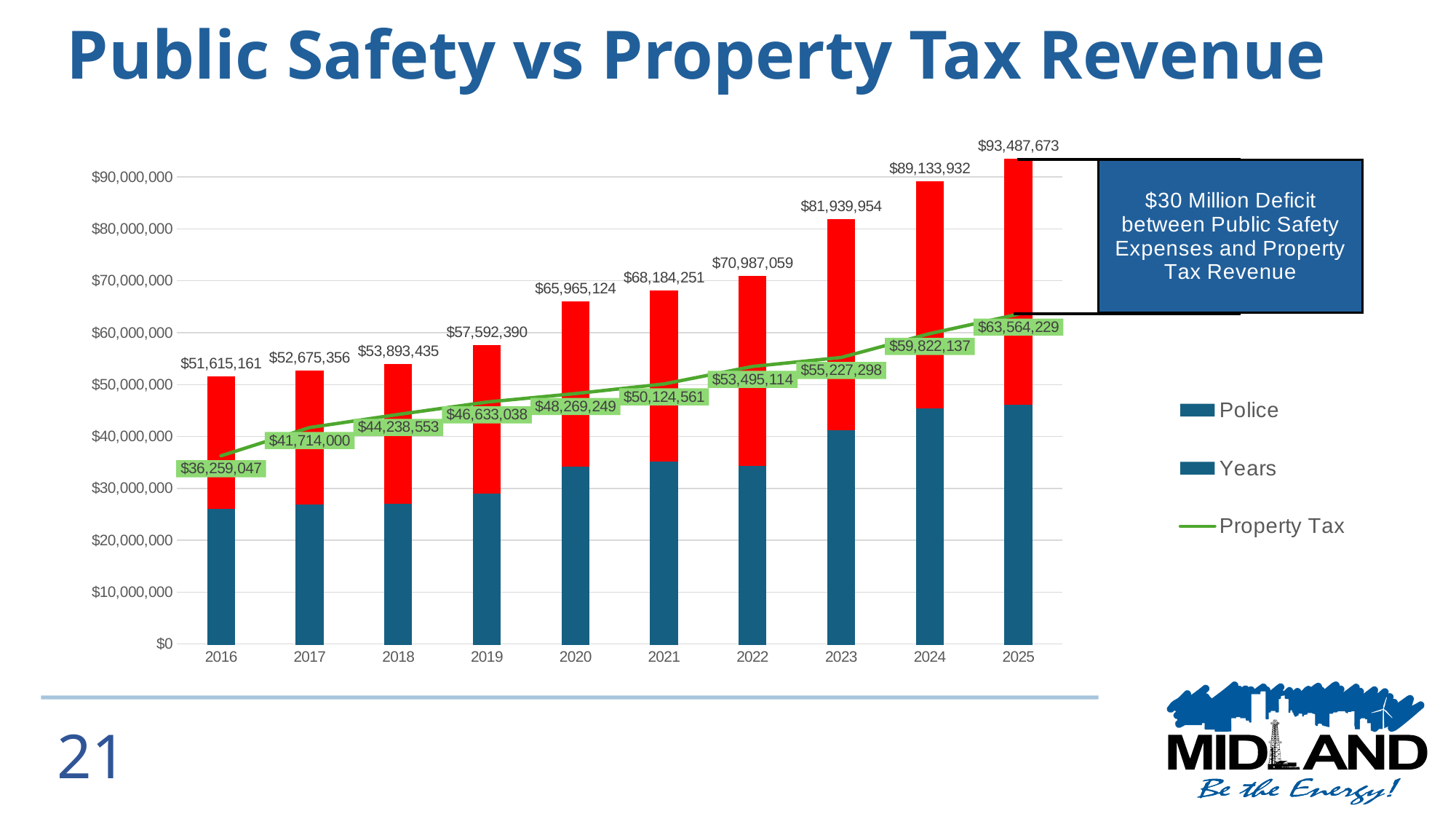
What is the Property Tax value labeled for 2021? $50,124,561 Which is larger, the bar total for 2020 or the bar total for 2019? 2020 Which year has the lowest Property Tax value? 2016 How many years are shown on the x axis? 10 Do the Property Tax values rise or fall from 2016 to 2025? rise How many series does the legend list? 3 Which year has the highest total labeled above its stacked bar? 2025 Is the Police value for 2016 greater or less than $30,000,000? less What is the difference between the 2025 bar total ($93,487,673) and the 2025 Property Tax value ($63,564,229)? $29,923,444 What is the Property Tax value labeled for 2016? $36,259,047 What is the total public safety expense labeled above the bar for 2025? $93,487,673 What is the difference between the bar totals for 2024 and 2023? $7,193,978